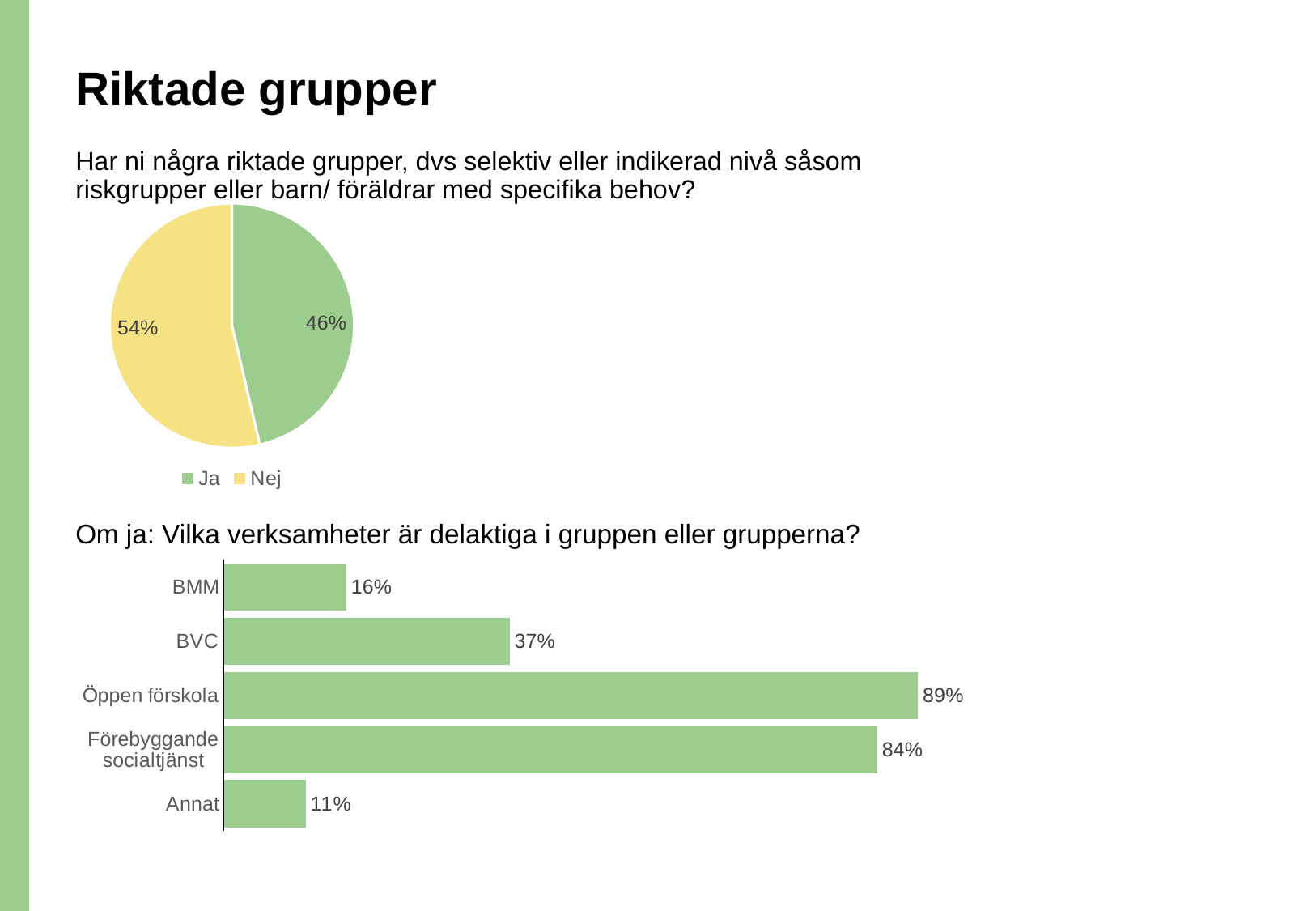
In the pie chart at the top of the slide, which answer has the larger share, Ja or Nej? Nej How many entries does the legend of the pie chart at the top of the slide list? 2 In the bar chart at the bottom of the slide, which category has the highest value? Öppen förskola In the pie chart at the top of the slide, what share of respondents answered "Ja"? 46% How many categories does the bar chart at the bottom of the slide show? 5 In the bar chart at the bottom of the slide, what is the difference between the values for Öppen förskola and BMM? 73% What kind of chart is the chart at the bottom of the slide? Bar chart In the pie chart at the top of the slide, what share of respondents answered "Nej"? 54% In the bar chart at the bottom of the slide, which category has the lowest value? Annat In the bar chart at the bottom of the slide, what is the value for BVC? 37% In the pie chart at the top of the slide, what colour is the Ja slice? Green In the bar chart at the bottom of the slide, what is the value for Förebyggande socialtjänst? 84%